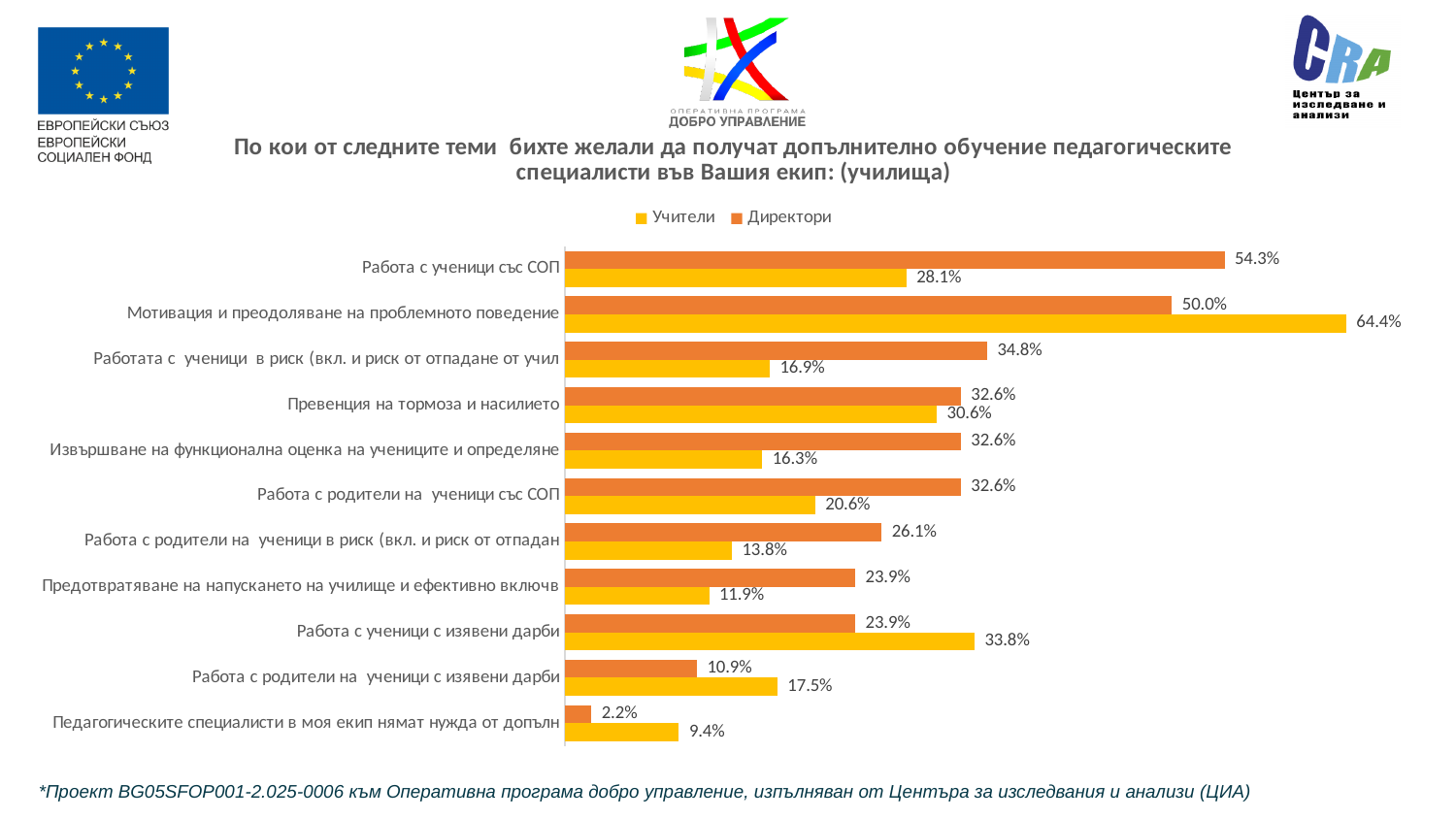
How many series does the legend list? 2 Which colour represents the Учители series in the chart? Yellow What is the value for Директори for "Работа с ученици със СОП"? 54.3% What is the value for Учители for "Работа с ученици с изявени дарби"? 33.8% What is the difference between the Директори and Учители values for "Работа с ученици със СОП"? 26.2% Which category has the lowest value for Учители? Педагогическите специалисти в моя екип нямат нужда от допълн What is the value for Учители for "Мотивация и преодоляване на проблемното поведение"? 64.4% What is the difference between the Учители and Директори values for "Мотивация и преодоляване на проблемното поведение"? 14.4% What kind of chart is shown on the slide? Bar chart For "Работа с родители на ученици с изявени дарби", which series has the larger value, Учители or Директори? Учители Which category has the highest value for Директори? Работа с ученици със СОП How many categories are shown in the chart? 11